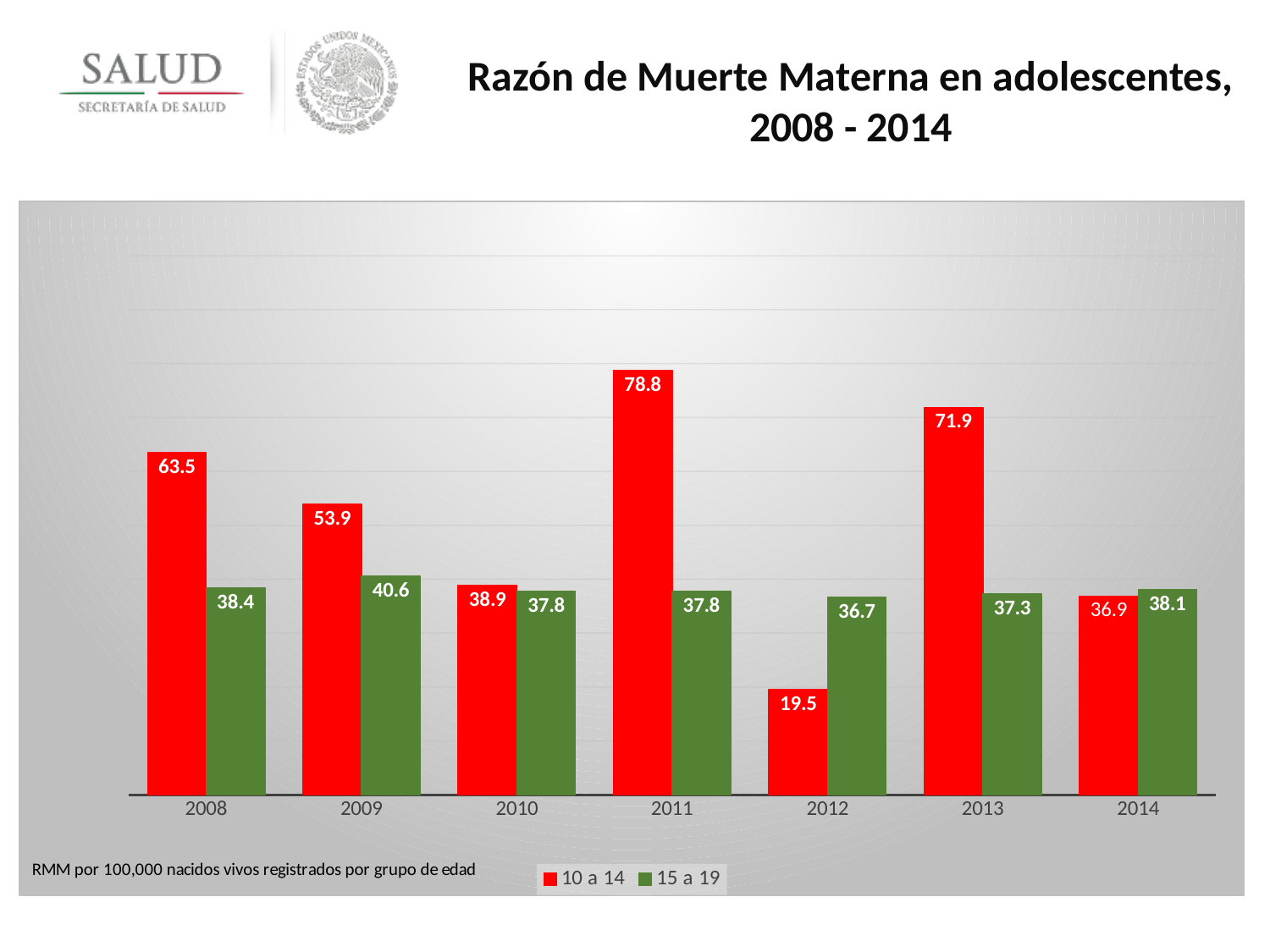
What colour represents the 15 a 19 series? Green What is the value for the 10 a 14 series in 2011? 78.8 In which year is the 10 a 14 series highest? 2011 In which year is the 10 a 14 series lowest? 2012 How many series does the legend list? 2 What kind of chart is shown on the slide? Bar chart How many years are shown on the x axis? 7 In which year is the 15 a 19 series highest? 2009 Which series has the larger value in 2012, 10 a 14 or 15 a 19? 15 a 19 What is the value for the 15 a 19 series in 2009? 40.6 What is the difference between the 10 a 14 and 15 a 19 values in 2013? 34.6 What is the value for the 10 a 14 series in 2012? 19.5